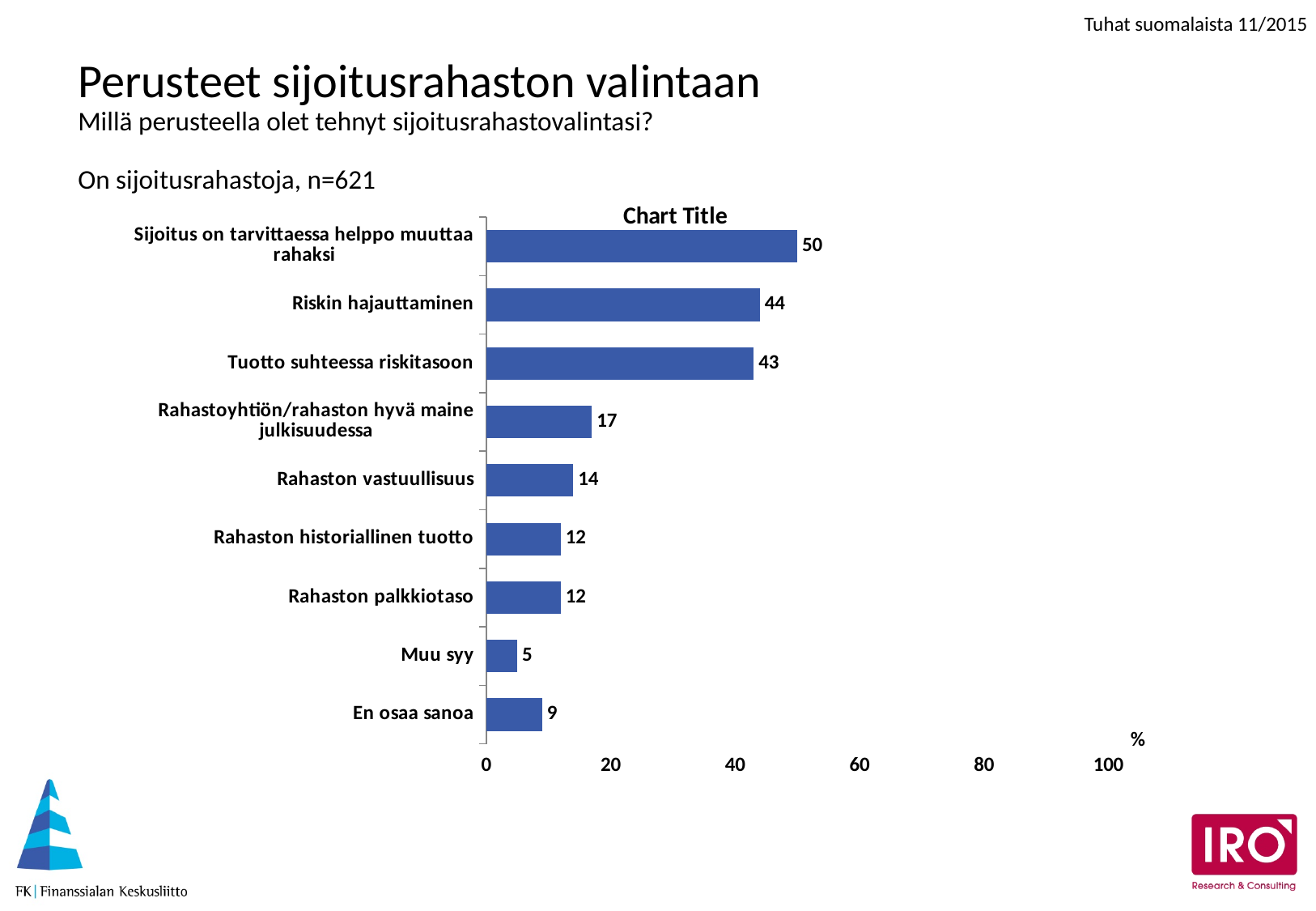
What is the sample size (n) stated above the chart? 621 How many categories are shown in the chart? 9 What is the difference between the values for "Sijoitus on tarvittaessa helppo muuttaa rahaksi" and "Tuotto suhteessa riskitasoon"? 7 What is the value for "Riskin hajauttaminen"? 44 What is the maximum value shown on the horizontal axis? 100 Which is larger, the value for "Rahastoyhtiön/rahaston hyvä maine julkisuudessa" or the value for "Rahaston historiallinen tuotto"? Rahastoyhtiön/rahaston hyvä maine julkisuudessa What is the value for "Rahaston vastuullisuus"? 14 What is the value for "En osaa sanoa"? 9 Is the value for "Riskin hajauttaminen" greater or less than 40? greater Which category has the highest value? Sijoitus on tarvittaessa helppo muuttaa rahaksi What kind of chart is shown on the slide? Bar chart Which category has the lowest value? Muu syy